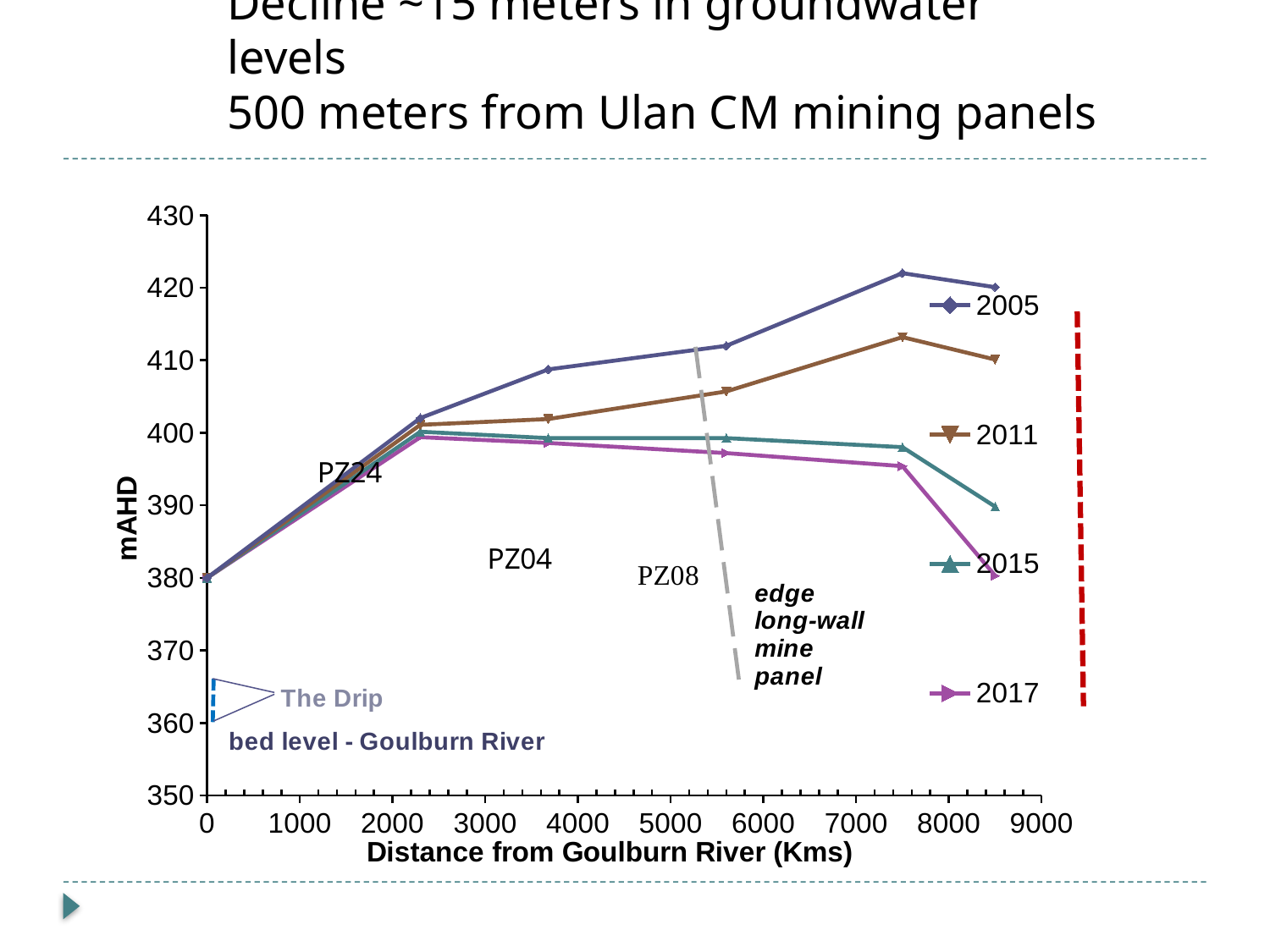
Does the 2017 series rise or fall between around 2300 and 8500 on the x axis? fall Which series has the lowest value at the far right of the chart (around 8500)? 2017 Which years are listed in the chart legend? 2005, 2011, 2015, 2017 Is the value for the 2011 series at around 7500 greater or less than 400? greater What is the mAHD value of all series at a distance of 0 from the Goulburn River? 380 Is the value for the 2005 series at around 7500 greater or less than 410? greater At around 8500, which series has the larger value, 2005 or 2017? 2005 How many series does the legend list? 4 Which series has the highest value at the far right of the chart (around 8500)? 2005 What kind of chart is shown on the slide? line chart Is the value for the 2017 series at around 8500 greater or less than 390? less What is the title of the x axis? Distance from Goulburn River (Kms)